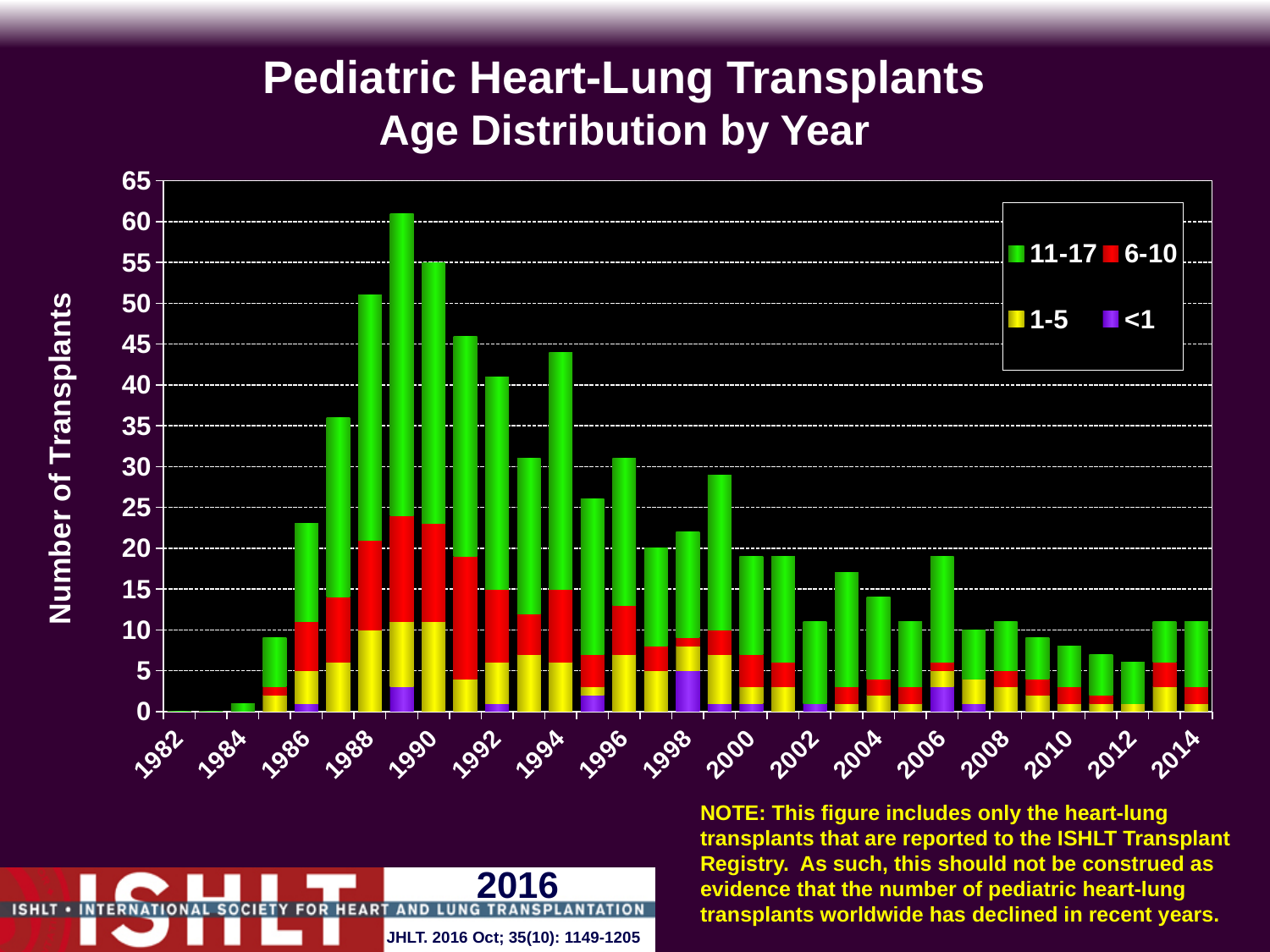
Is the total number of transplants in 2012 greater or less than 10? less Is the total number of transplants in 1986 greater or less than 20? greater Is the total number of transplants in 2003 greater or less than 20? less Which year has a higher total number of transplants, 1994 or 1995? 1994 How many age-group series does the legend list? 4 What is the label on the vertical axis of the chart? Number of Transplants Which year has a higher total number of transplants, 1989 or 2014? 1989 What kind of chart is shown on the slide? Stacked bar chart From 1989 to 2012, do the total numbers of transplants generally rise or fall? Fall Which year has the highest total number of pediatric heart-lung transplants? 1989